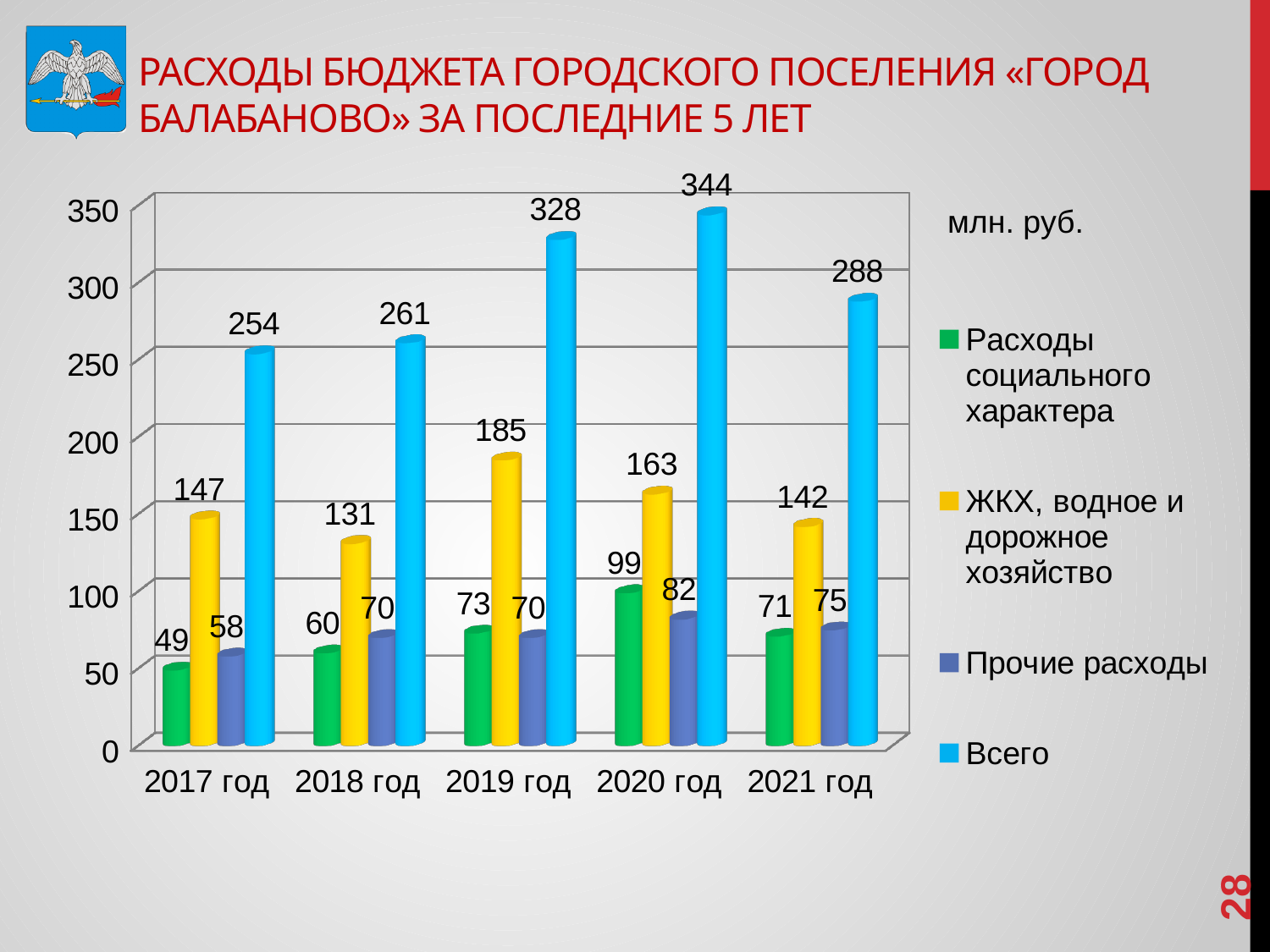
What is the value of «Прочие расходы» for 2021 год? 75 What kind of chart is shown on the slide? Bar chart In which year is «Расходы социального характера» the lowest? 2017 год What is the difference between «Всего» in 2020 год and 2021 год? 56 What is the value of «Всего» for 2020 год? 344 How many series does the legend list? 4 What is the value of «Расходы социального характера» for 2017 год? 49 What is the value of «ЖКХ, водное и дорожное хозяйство» for 2019 год? 185 What unit of measurement is indicated next to the chart? млн. руб. How many years are shown on the x axis? 5 Which is larger: «ЖКХ, водное и дорожное хозяйство» in 2018 год or in 2021 год? 2021 год In which year is «Всего» the highest? 2020 год